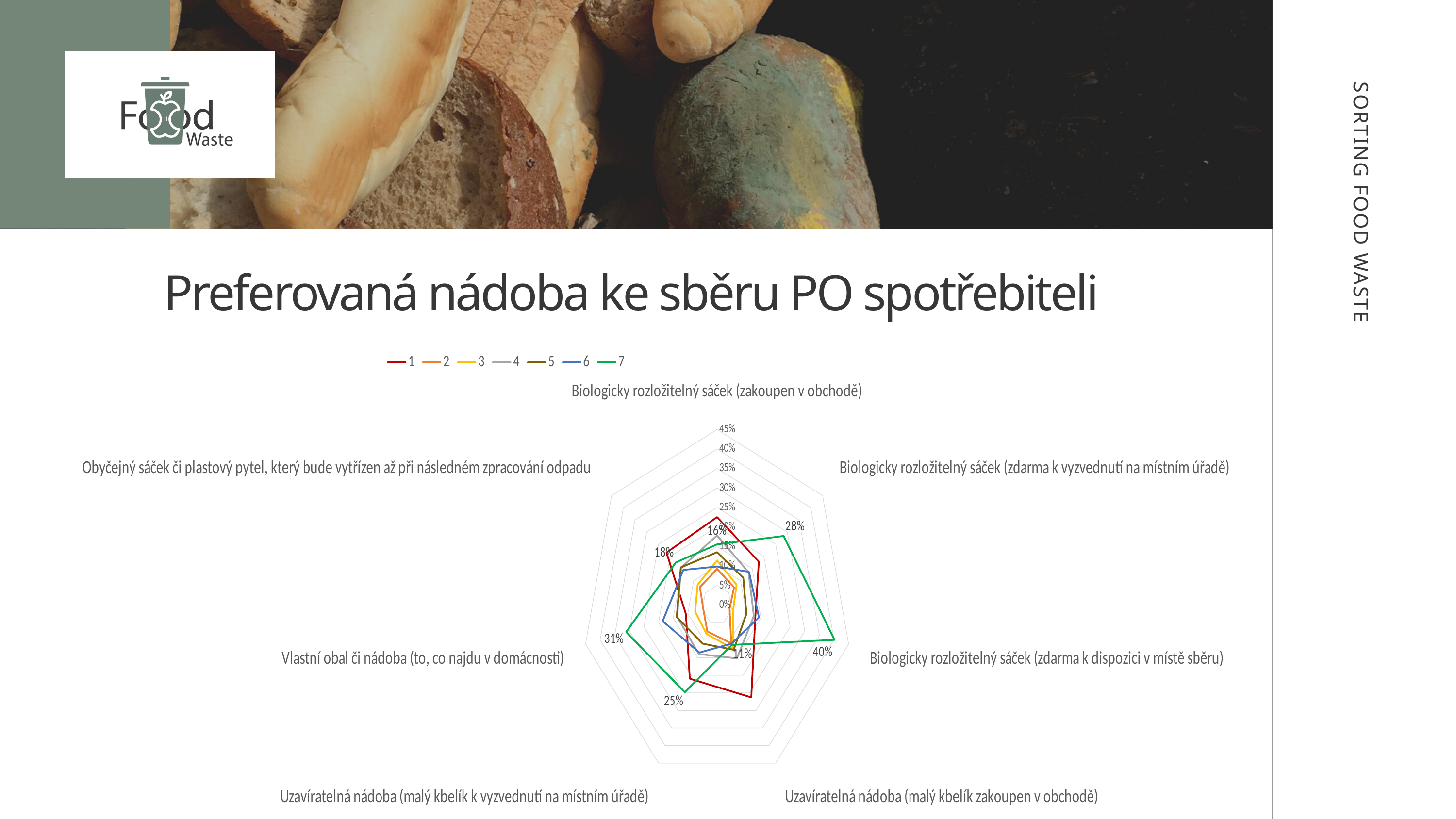
How many series does the legend of the chart list? 7 What is the value of series 7 for 'Biologicky rozložitelný sáček (zdarma k dispozici v místě sběru)'? 40% How many categories (axes) does the radar chart have? 7 What kind of chart is shown on the slide? radar chart What is the highest value shown on the radar chart's axis scale? 45% For series 7, what is the difference between the value for 'Biologicky rozložitelný sáček (zdarma k dispozici v místě sběru)' and 'Biologicky rozložitelný sáček (zdarma k vyzvednutí na místním úřadě)'? 12 percentage points For series 7, which category has the lowest value? Uzavíratelná nádoba (malý kbelík zakoupen v obchodě) For series 7, which is larger: the value for 'Vlastní obal či nádoba' or for 'Obyčejný sáček či plastový pytel'? Vlastní obal či nádoba For series 7, which category has the highest value? Biologicky rozložitelný sáček (zdarma k dispozici v místě sběru) What is the value of series 7 for 'Vlastní obal či nádoba (to, co najdu v domácnosti)'? 31% What is the value of series 7 for 'Biologicky rozložitelný sáček (zdarma k vyzvednutí na místním úřadě)'? 28% What is the value of series 7 for 'Uzavíratelná nádoba (malý kbelík zakoupen v obchodě)'? 11%